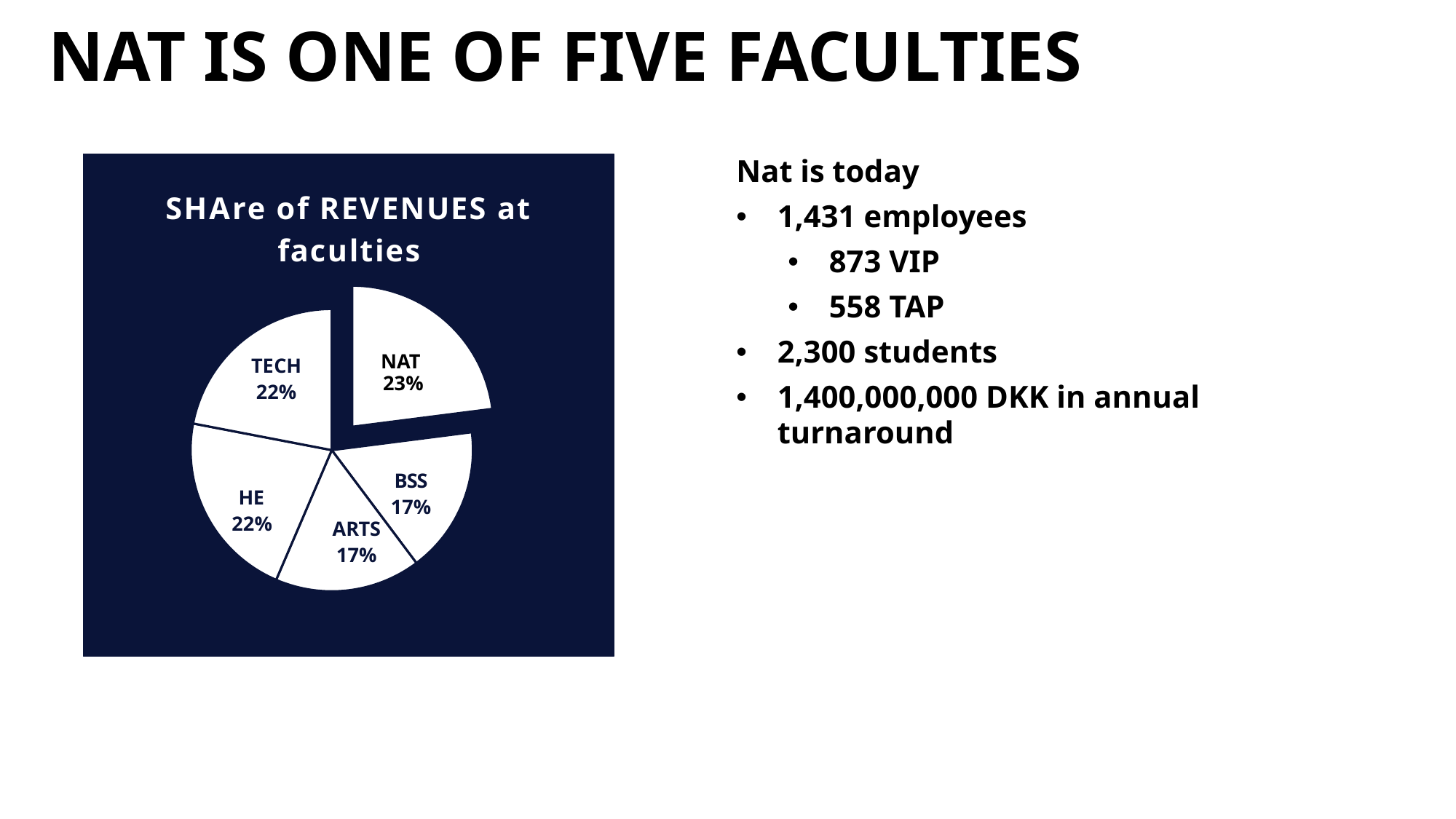
What is the difference in percentage points between NAT's share and BSS's share? 6 What share of revenues does ARTS have? 17% What share of revenues does HE have? 22% How many faculties are shown in the pie chart? 5 What type of chart is shown on the slide? pie chart What is the title of the chart? SHAre of REVENUES at faculties Which has a larger share of revenues, NAT or ARTS? NAT Which faculty has the largest share of revenues? NAT What share of revenues does NAT have? 23% What share of revenues does BSS have? 17% Which slice of the pie chart is pulled out from the rest? NAT What share of revenues does TECH have? 22%